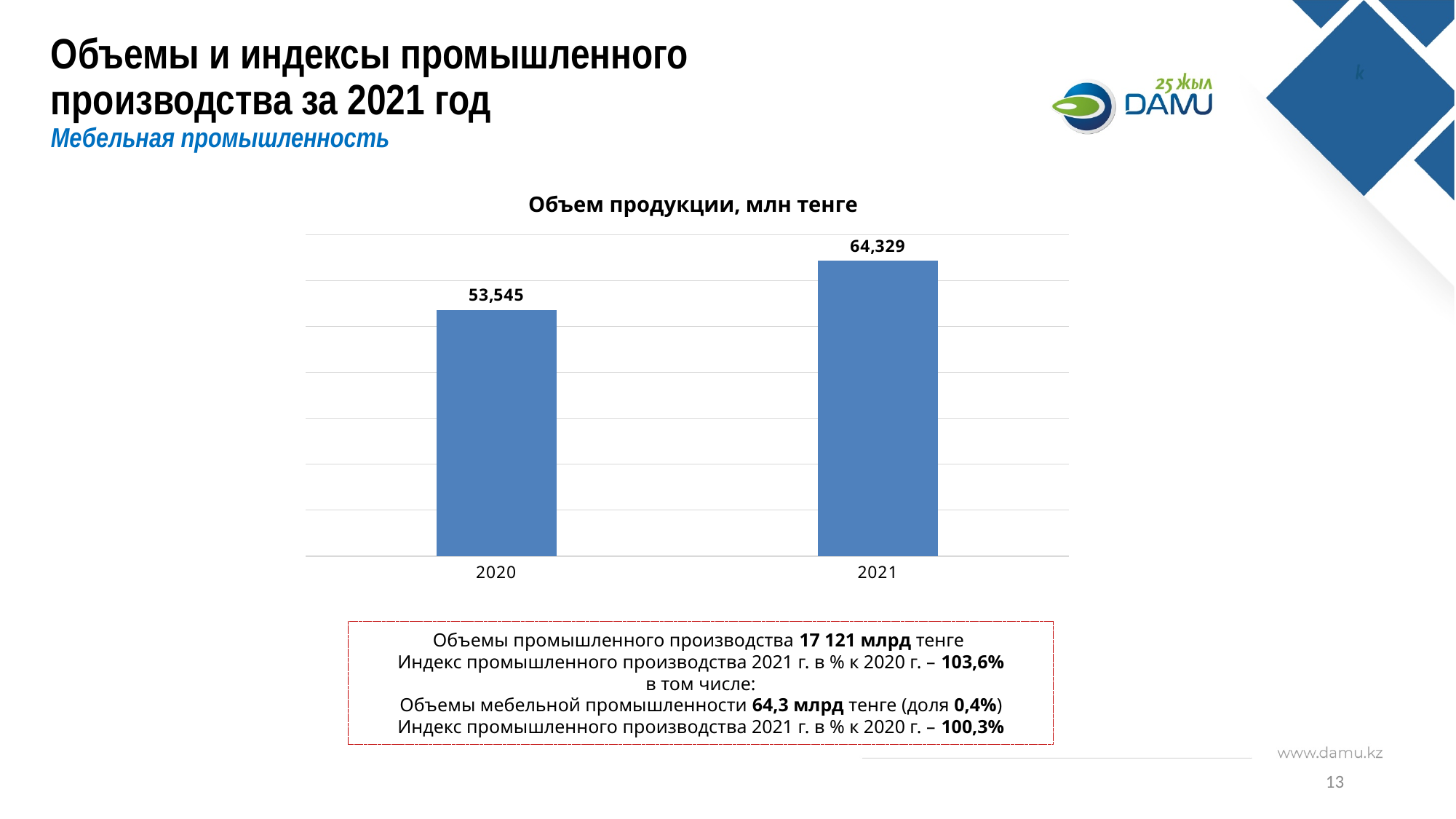
What is the title of the chart? Объем продукции, млн тенге What is the difference between the values for 2021 and 2020? 10,784 What is the value for 2020 in the chart? 53,545 What is the value for 2021 in the chart? 64,329 What colour are the bars in the chart? Blue Do the values rise or fall from 2020 to 2021? Rise Which year has the highest value in the chart? 2021 How many bars are shown in the chart? 2 Which year has the lowest value in the chart? 2020 Which is larger, the value for 2020 or the value for 2021? 2021 What kind of chart is shown on the slide? Bar chart